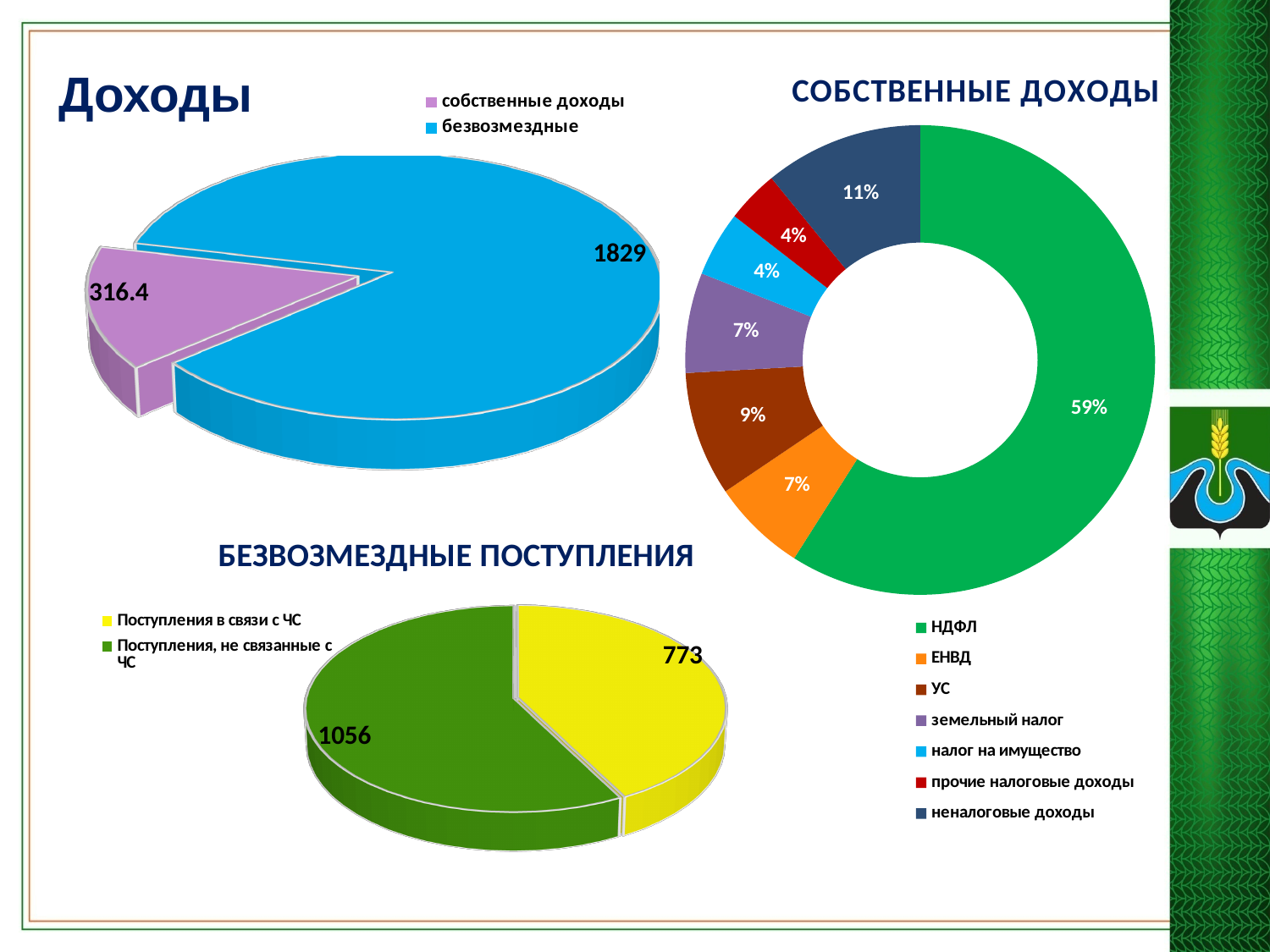
In the 'Доходы' chart, which category is larger, собственные доходы or безвозмездные? безвозмездные In the 'Доходы' chart, what is the value for безвозмездные? 1829 In the 'БЕЗВОЗМЕЗДНЫЕ ПОСТУПЛЕНИЯ' chart, what is the value for Поступления в связи с ЧС? 773 In the 'БЕЗВОЗМЕЗДНЫЕ ПОСТУПЛЕНИЯ' chart, what is the total of the two slices? 1829 In the 'СОБСТВЕННЫЕ ДОХОДЫ' chart, which category has the largest share? НДФЛ In the 'СОБСТВЕННЫЕ ДОХОДЫ' chart, what share does НДФЛ have? 59% What kind of chart is the 'БЕЗВОЗМЕЗДНЫЕ ПОСТУПЛЕНИЯ' chart? pie chart In the 'Доходы' chart, what is the value for собственные доходы? 316.4 How many categories does the legend of the 'СОБСТВЕННЫЕ ДОХОДЫ' chart list? 7 In the 'СОБСТВЕННЫЕ ДОХОДЫ' chart, what share does УС have? 9% In the 'СОБСТВЕННЫЕ ДОХОДЫ' chart, what share does неналоговые доходы have? 11% In the 'Доходы' chart, what is the difference between безвозмездные and собственные доходы? 1512.6